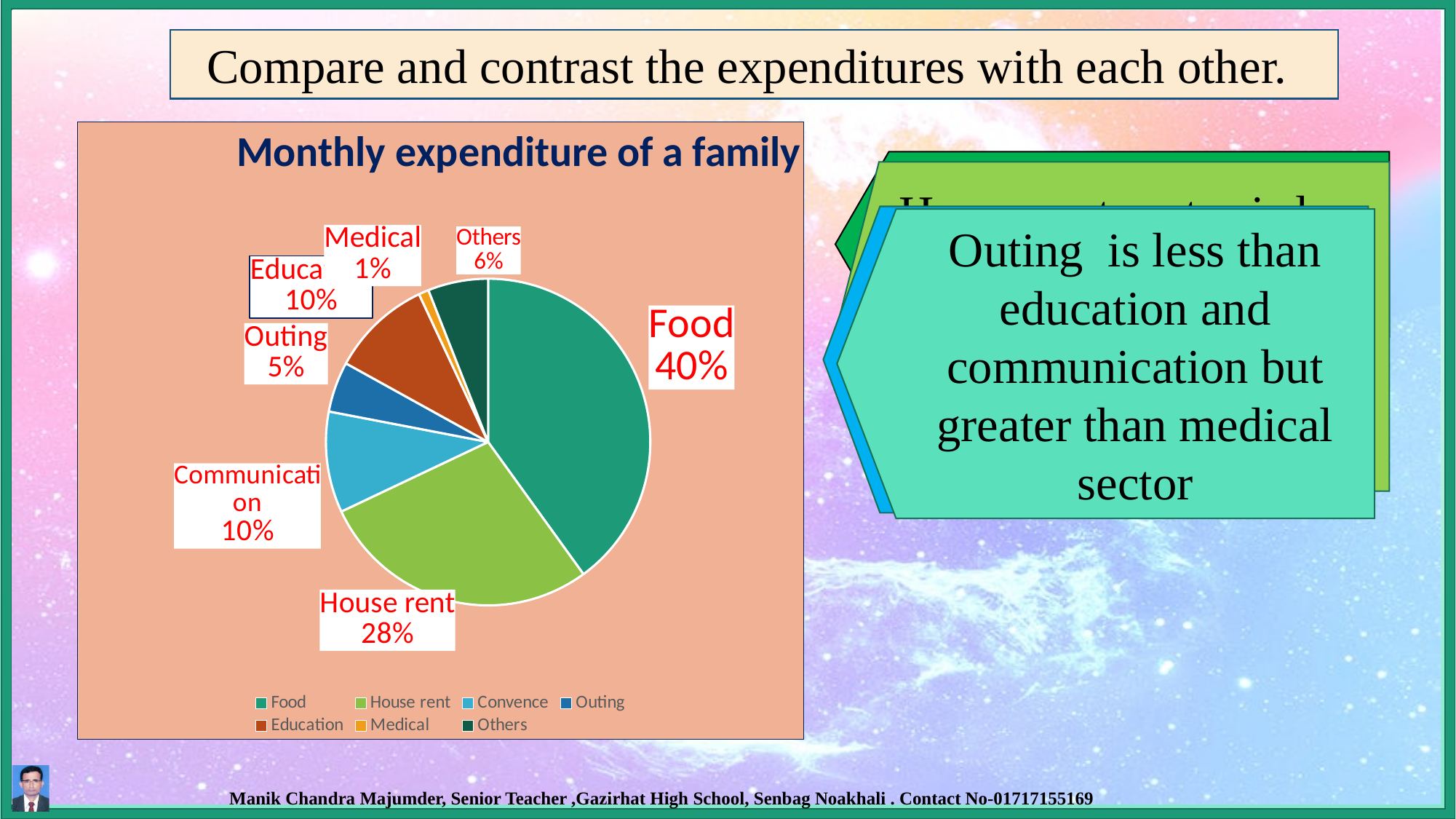
Which expenditure category has the smallest share of the pie? Medical What kind of chart is shown on the slide? Pie chart What is the title of the chart? Monthly expenditure of a family What percentage of the monthly expenditure goes to Food? 40% Which expenditure category has the largest share of the pie? Food What percentage of the monthly expenditure goes to Medical? 1% What percentage of the monthly expenditure goes to House rent? 28% How many entries does the legend list? 7 Which is larger, the share for Outing or the share for Others? Others What is the difference in percentage points between Food and House rent? 12 How many slices does the pie chart have? 7 What percentage of the monthly expenditure goes to Others? 6%